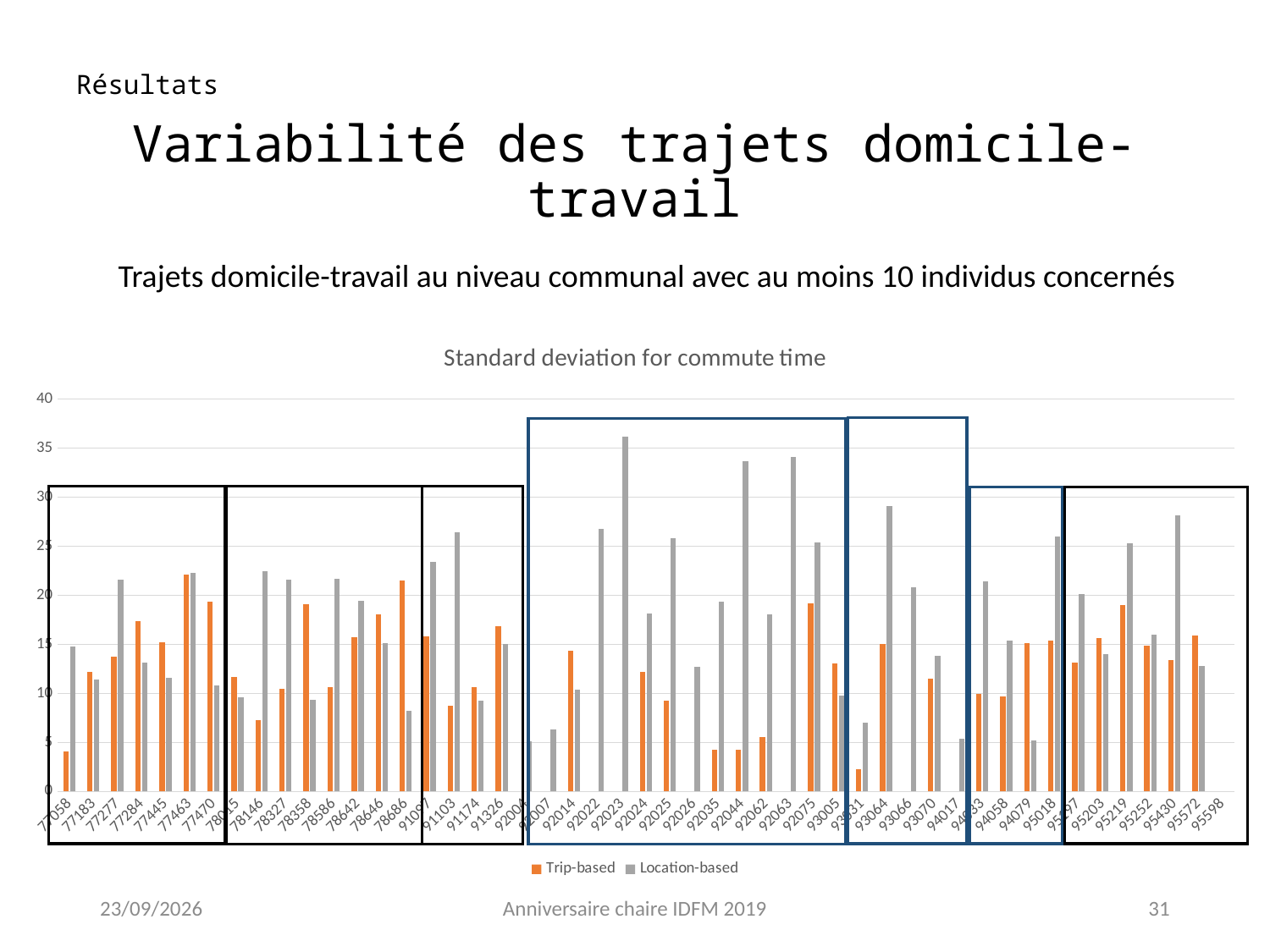
Is the Location-based value for 95430 greater or less than 25? greater Which is larger, the Trip-based value for 77463 or the Trip-based value for 77058? 77463 Is the Trip-based value for 77058 greater or less than 5? less Is the Trip-based value for 92075 greater or less than 15? greater How many series does the legend of the chart list? 2 What is the title of the chart? Standard deviation for commute time Which category has the highest Location-based value? 92023 Which colour represents the Trip-based series in the chart? orange What kind of chart is shown on the slide? bar chart